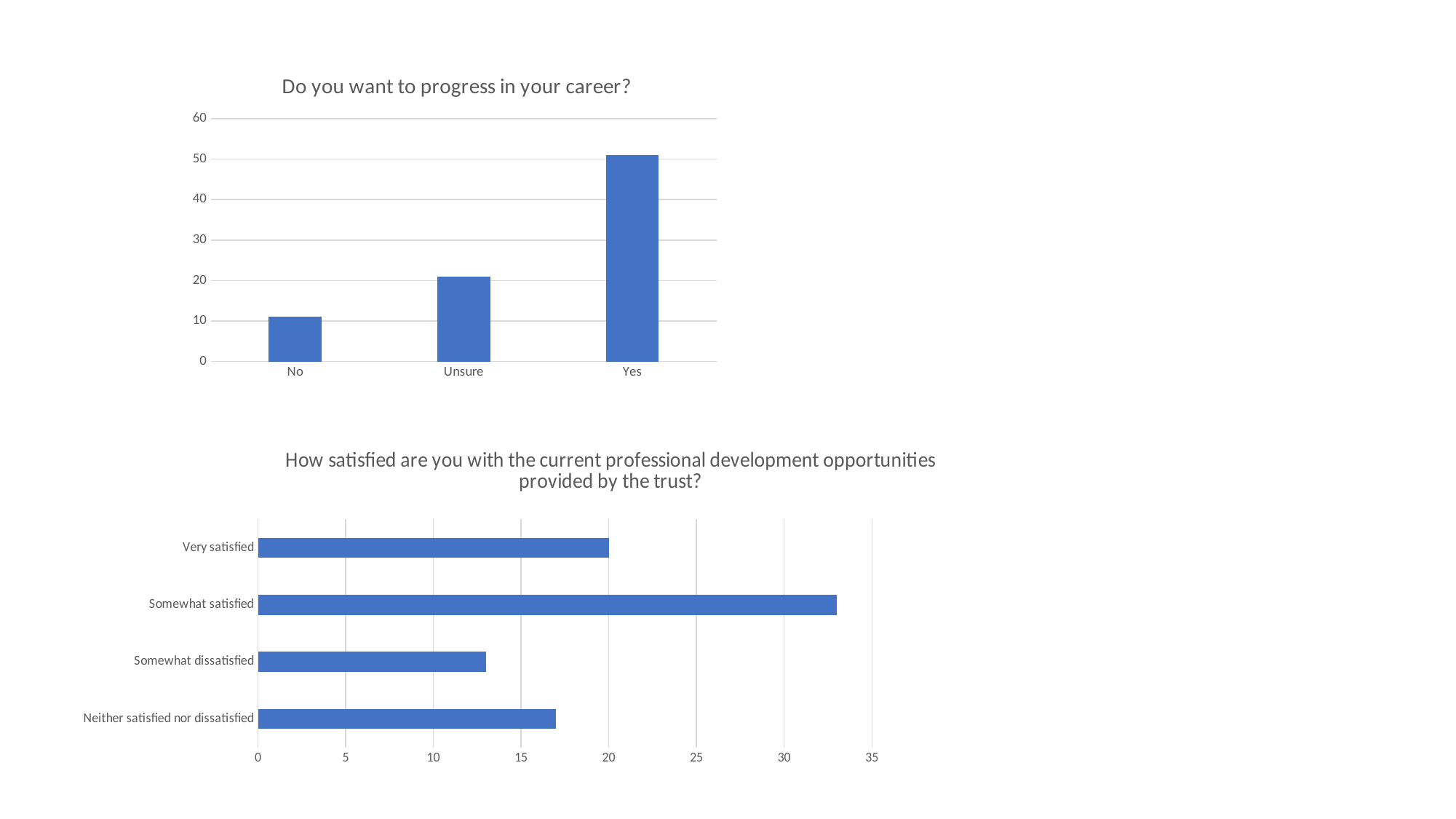
In the chart 'How satisfied are you with the current professional development opportunities provided by the trust?', which is larger: Very satisfied or Neither satisfied nor dissatisfied? Very satisfied In the chart 'Do you want to progress in your career?', how many categories are shown on the x axis? 3 In the chart 'How satisfied are you with the current professional development opportunities provided by the trust?', what is the highest value shown on the horizontal axis? 35 In the chart 'How satisfied are you with the current professional development opportunities provided by the trust?', how many categories are shown? 4 What type of chart is 'Do you want to progress in your career?'? bar chart In the chart 'How satisfied are you with the current professional development opportunities provided by the trust?', which category has the highest value? Somewhat satisfied In the chart 'How satisfied are you with the current professional development opportunities provided by the trust?', is the value for Somewhat satisfied greater or less than 30? greater In the chart 'Do you want to progress in your career?', which category has the highest value? Yes In the chart 'Do you want to progress in your career?', which category has the lowest value? No In the chart 'How satisfied are you with the current professional development opportunities provided by the trust?', which category has the lowest value? Somewhat dissatisfied